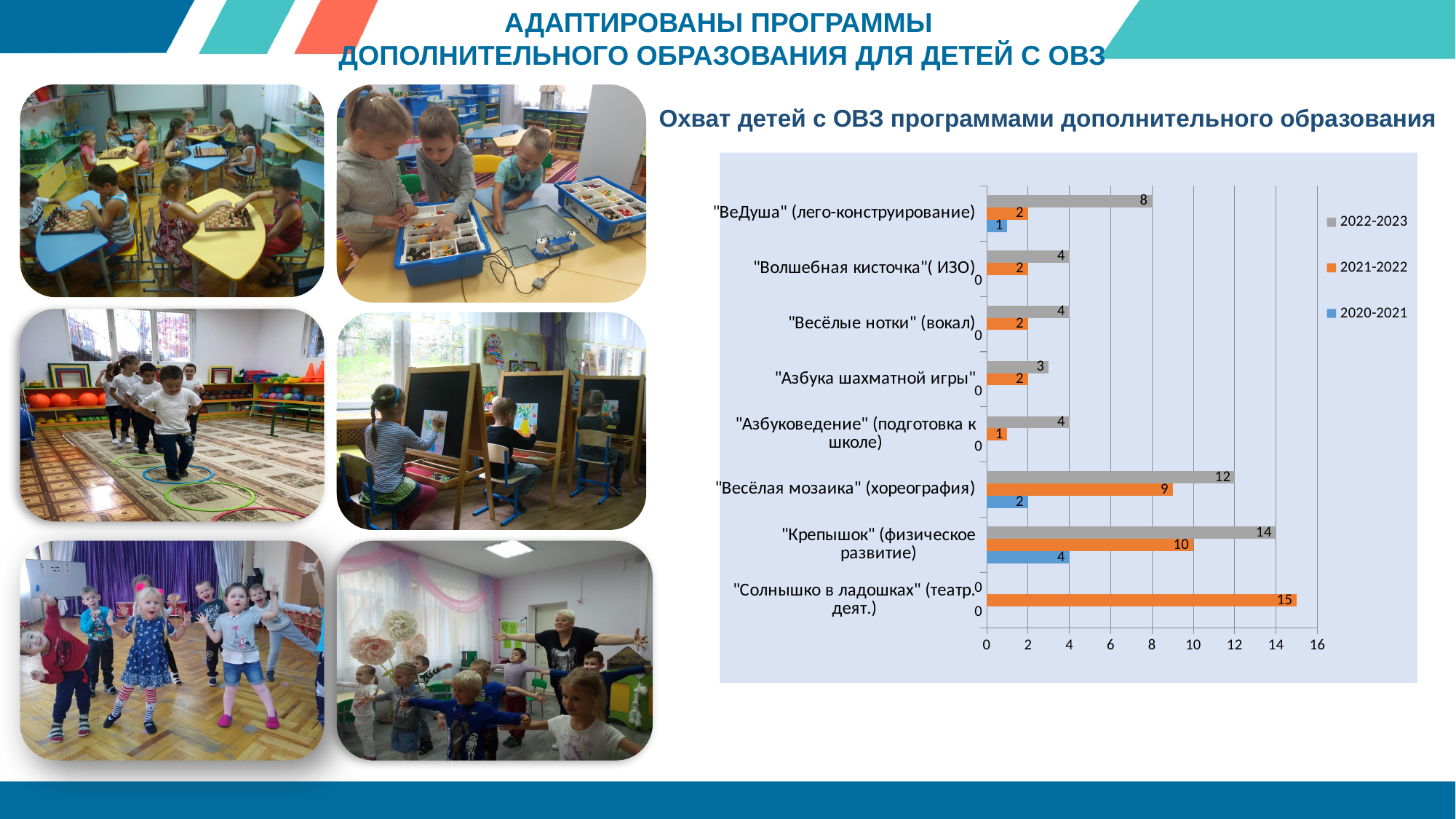
What kind of chart is shown on the slide? Bar chart Which category has the lowest value in the 2022-2023 series? "Солнышко в ладошках" (театр. деят.) Which is larger for "ВеДуша" (лего-конструирование): the 2022-2023 value or the 2021-2022 value? 2022-2023 What is the value for "Крепышок" (физическое развитие) in the 2022-2023 series? 14 How many categories (programmes) are shown on the chart? 8 What is the value for "ВеДуша" (лего-конструирование) in the 2020-2021 series? 1 What is the value for "Солнышко в ладошках" (театр. деят.) in the 2021-2022 series? 15 What is the difference between the 2022-2023 and 2021-2022 values for "Весёлая мозаика" (хореография)? 3 What is the title of the chart? Охват детей с ОВЗ программами дополнительного образования What is the total of the three series values for "Крепышок" (физическое развитие)? 28 Which category has the highest value in the 2022-2023 series? "Крепышок" (физическое развитие) How many series does the legend list? 3